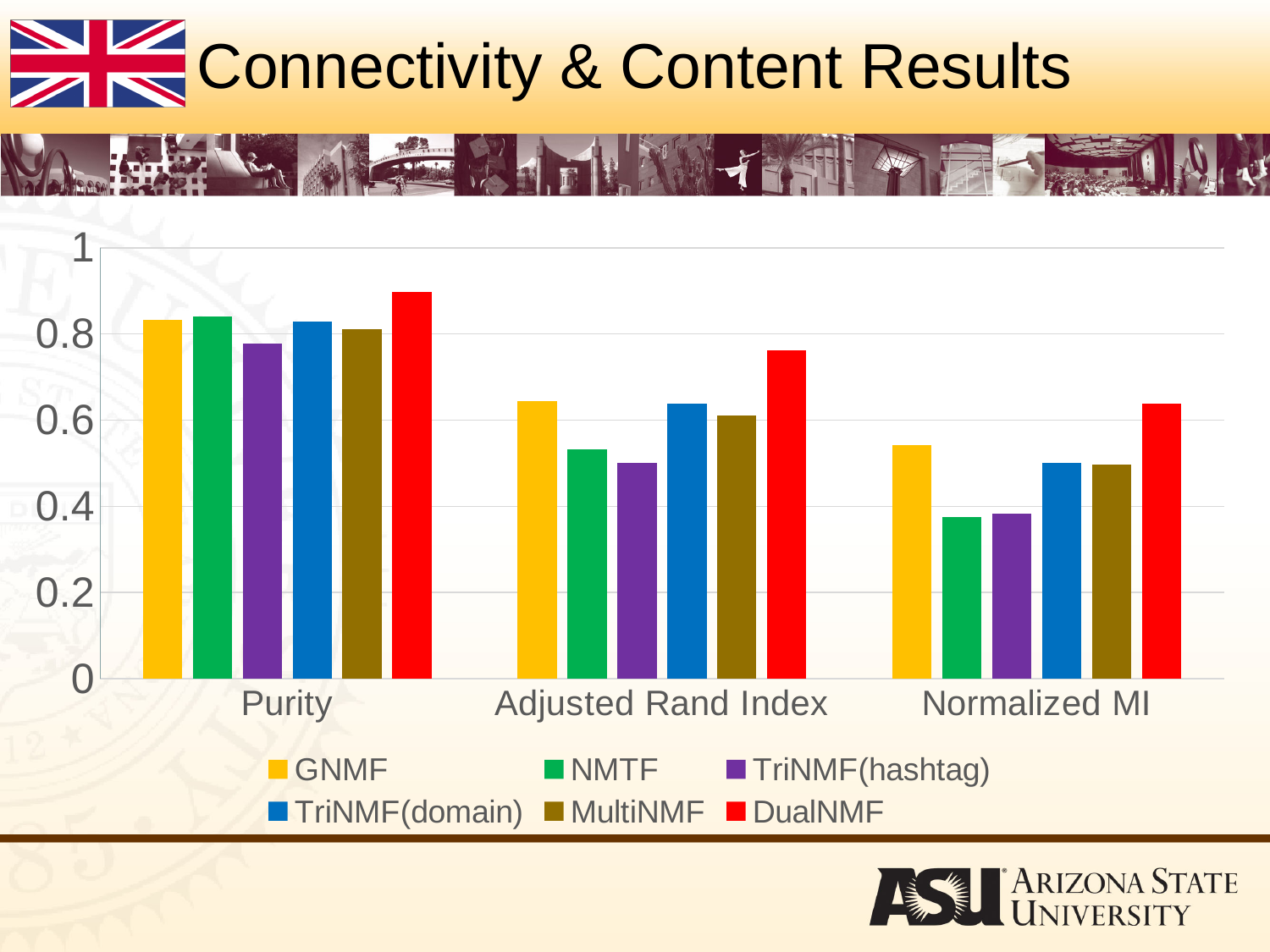
Which method has the highest Purity value? DualNMF Is the Adjusted Rand Index value for GNMF greater or less than 0.6? greater How many series does the chart's legend list? 6 For Adjusted Rand Index, which is larger: the value for DualNMF or the value for MultiNMF? DualNMF Which method has the highest Adjusted Rand Index value? DualNMF What colour represents DualNMF in the chart's legend? red How many categories are shown along the x axis of the chart? 3 What kind of chart is shown on the slide? bar chart For Normalized MI, which is larger: the value for GNMF or the value for NMTF? GNMF Is the Purity value for DualNMF greater or less than 0.8? greater Which method has the lowest Purity value? TriNMF(hashtag) Is the Normalized MI value for NMTF greater or less than 0.4? less